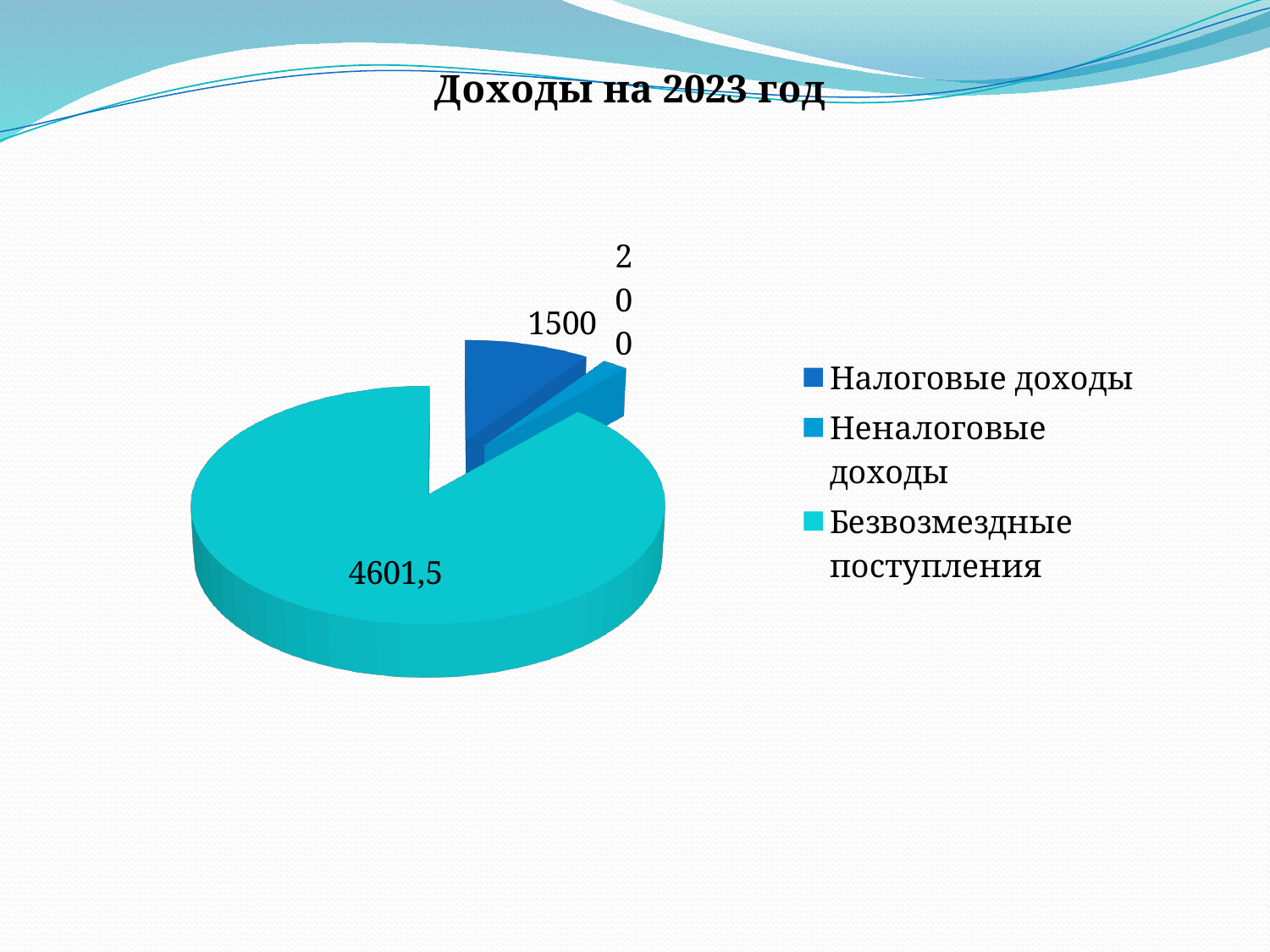
Which category has the smallest slice of the pie? Неналоговые доходы Which category has the largest slice of the pie? Безвозмездные поступления What is the value for Неналоговые доходы? 200 What is the value for Налоговые доходы? 1500 How many categories does the pie chart have? 3 What is the difference between Безвозмездные поступления and Налоговые доходы? 3101,5 What is the total of all three slices in the pie chart? 6301,5 Which is larger, Налоговые доходы or Неналоговые доходы? Налоговые доходы What type of chart is shown on the slide? Pie chart What is the difference between Налоговые доходы and Неналоговые доходы? 1300 What is the title of the chart? Доходы на 2023 год What is the value for Безвозмездные поступления? 4601,5